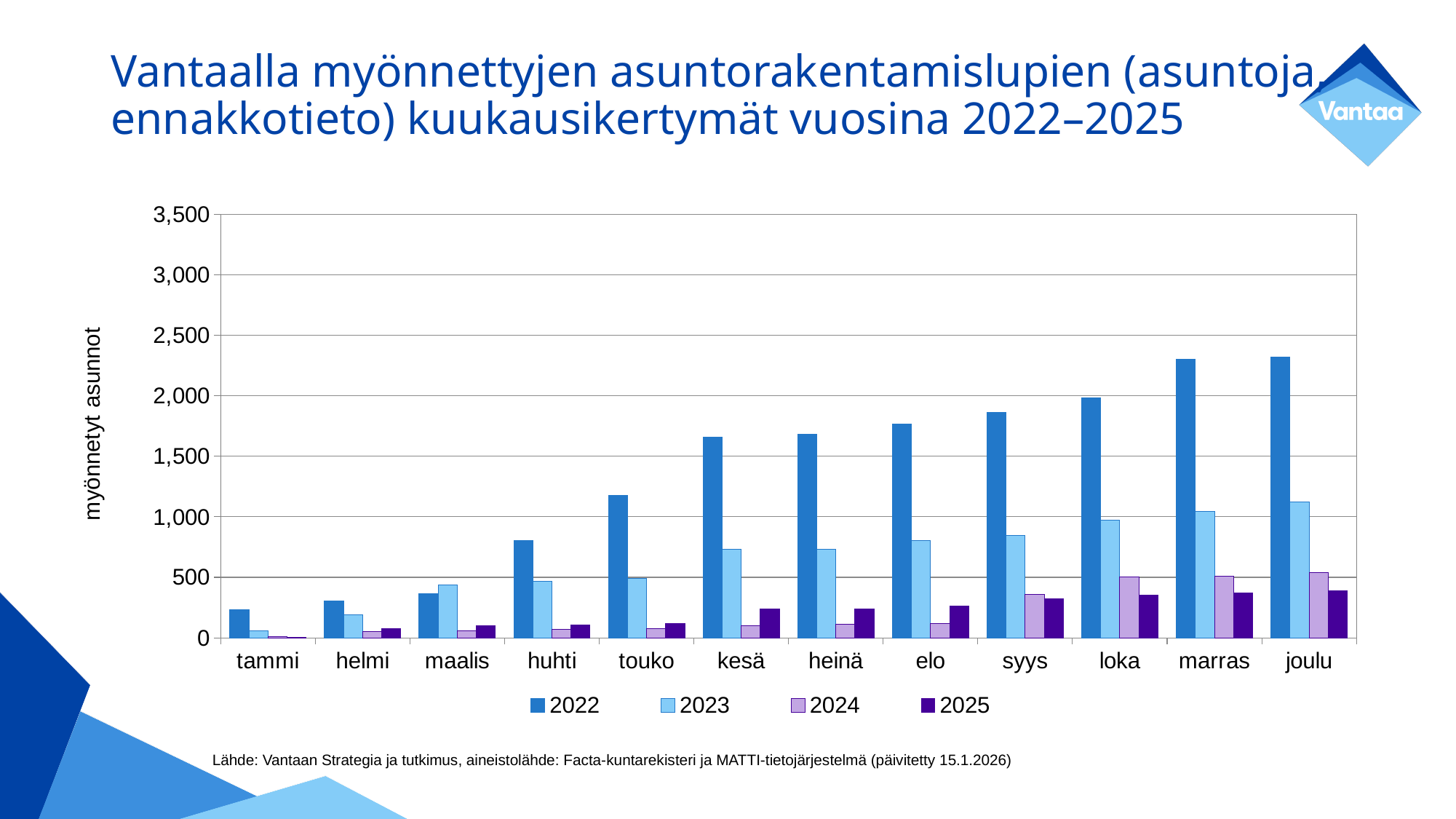
Is the value for 2022 in touko greater or less than 1,000? greater How many months are shown on the x axis? 12 Is the value for 2022 in joulu greater or less than 2,000? greater What is the label on the y axis? myönnetyt asunnot How many series does the legend list? 4 Is the value for 2025 in joulu greater or less than 500? less In maalis, which series has the larger value, 2022 or 2023? 2023 What kind of chart is shown on the slide? bar chart Do the 2022 values rise or fall from tammi to joulu? rise In joulu, which series has the larger value, 2022 or 2023? 2022